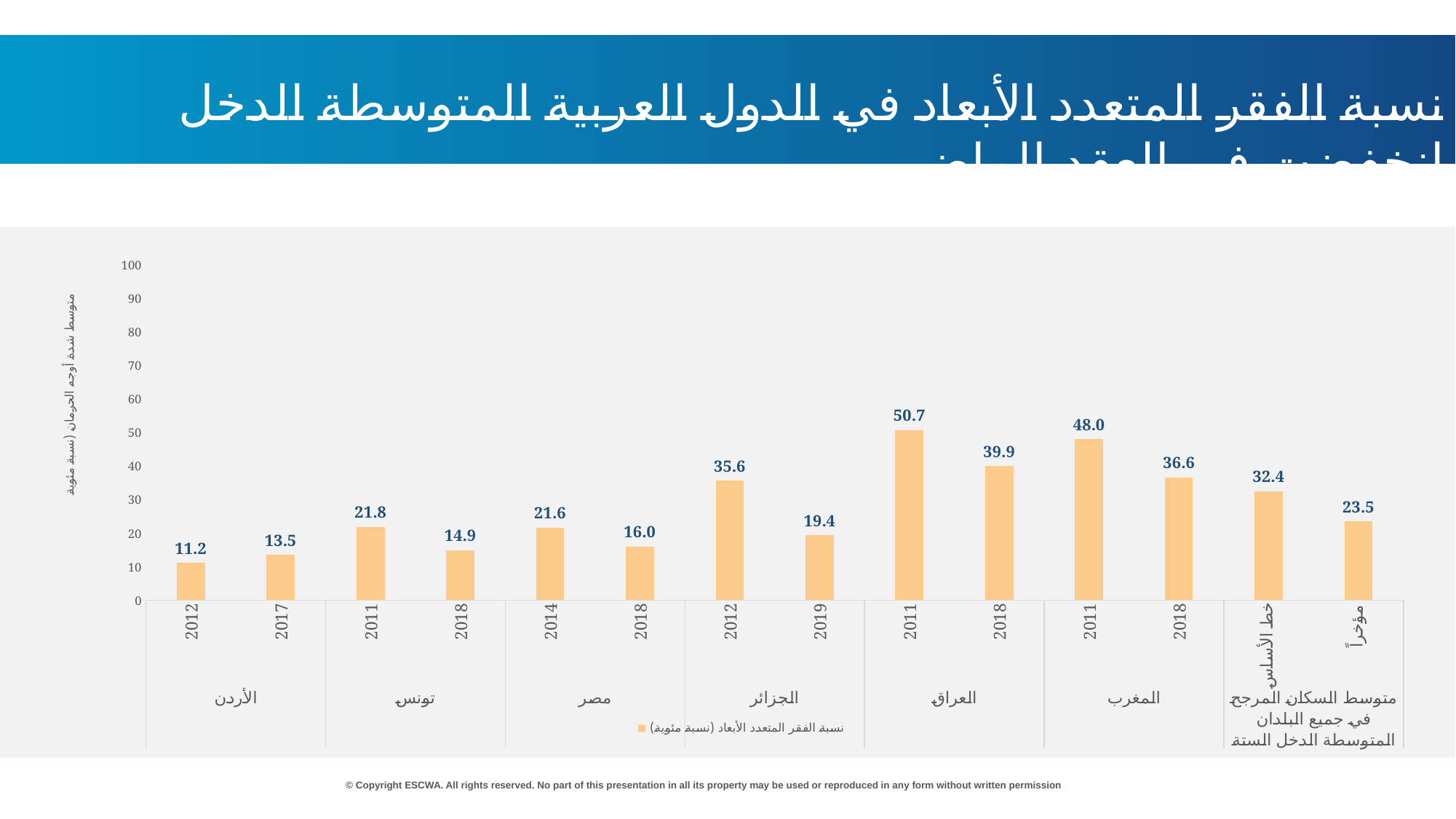
Is the value for المغرب (Morocco) in 2011 greater or less than 40? greater Which bar has the lowest value in the chart? الأردن 2012 (11.2) By how much did the value for الجزائر (Algeria) fall from 2012 to 2019? 16.2 What kind of chart is shown on the slide? Bar chart What is the value for المغرب (Morocco) in 2018? 36.6 Which bar has the highest value in the chart? العراق 2011 (50.7) What is the difference between the baseline (خط الأساس) and recent (مؤخراً) values for the weighted population average of the six middle-income countries? 8.9 How many bars are plotted in the chart? 14 What value is shown for الأردن (Jordan) in 2017? 13.5 How many series does the legend list? 1 What is the multidimensional poverty rate shown for العراق (Iraq) in 2011? 50.7 Which is larger: the value for تونس (Tunisia) in 2011 or for مصر (Egypt) in 2014? تونس 2011 (21.8)